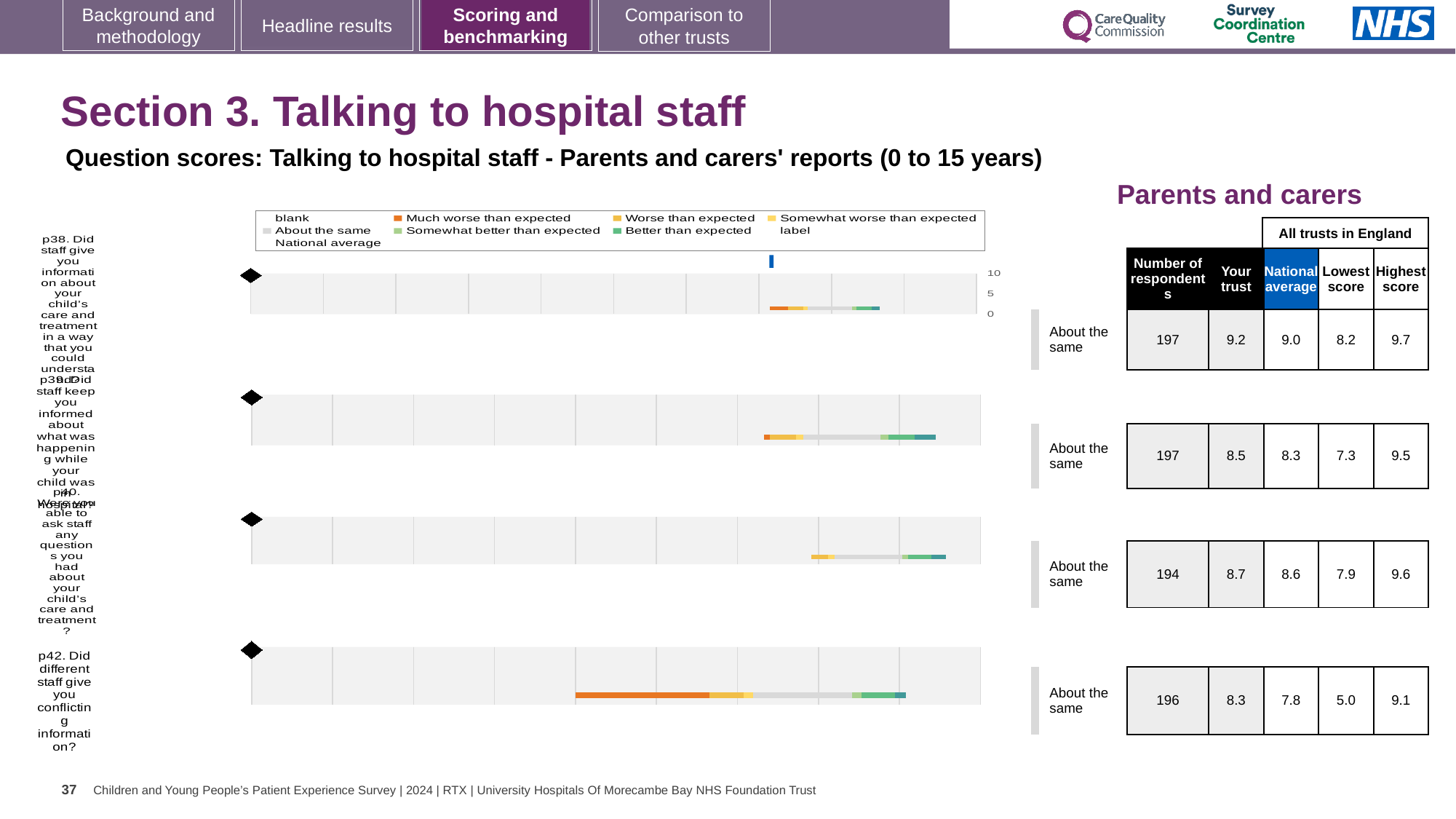
For the p38 chart, what is the Highest score among all trusts in England? 9.7 Which question chart has the lowest 'Lowest score' among all trusts in England? p42 For the p42 chart, what is the Lowest score among all trusts in England? 5.0 For the p42 chart, what is the difference between the 'Your trust' score and the National average? 0.5 For the p38 chart (staff giving information about your child's care and treatment), what is the 'Your trust' score? 9.2 What benchmark category is shown next to each of the four question charts? About the same For the p42 chart (different staff giving conflicting information), what is the National average score? 7.8 Which question chart has the highest 'Your trust' score? p38 What kind of chart is used to show the question scores on this slide? bar chart How many question charts (p38, p39, p40, p42) are shown on the slide? 4 For the p39 chart (staff keeping you informed), which is larger: the 'Your trust' score or the National average? Your trust For the p40 chart (being able to ask staff any questions), how many respondents are there? 194